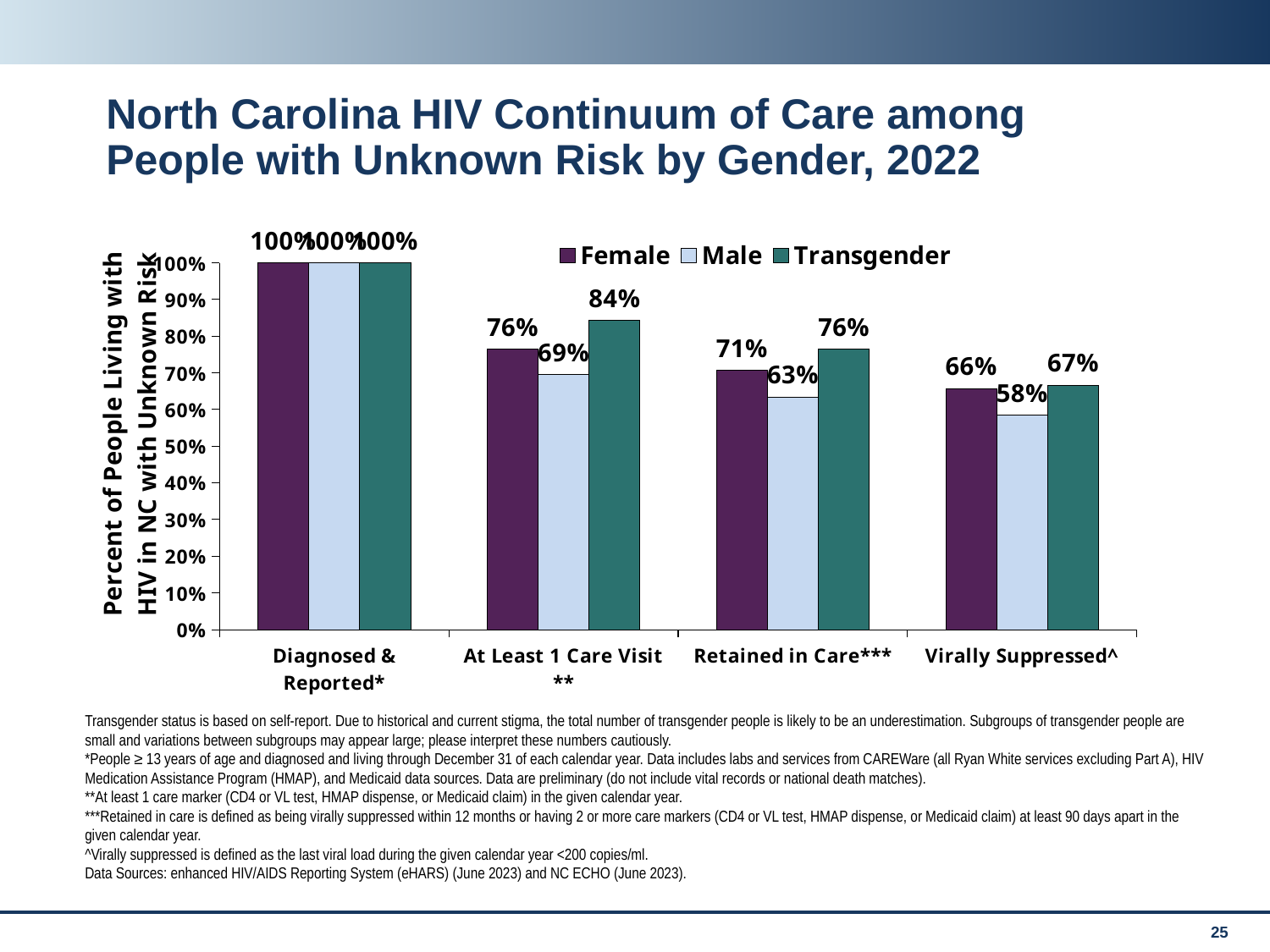
What is the value for Male in the Virally Suppressed category? 58% What is the difference between the Female and Male values in the Virally Suppressed category? 8% What is the difference between the Transgender and Male values in the At Least 1 Care Visit category? 15% How many categories are shown on the x axis? 4 How many series does the legend list? 3 Which is larger, the Female value for Retained in Care or the Male value for Retained in Care? Female Which series has the lowest value in the At Least 1 Care Visit category? Male Do the Male values rise or fall across the categories from left to right? Fall What is the value for Female in the Retained in Care category? 71% What is the value for Transgender in the At Least 1 Care Visit category? 84% What kind of chart is shown on the slide? Bar chart Which series has the highest value in the Retained in Care category? Transgender